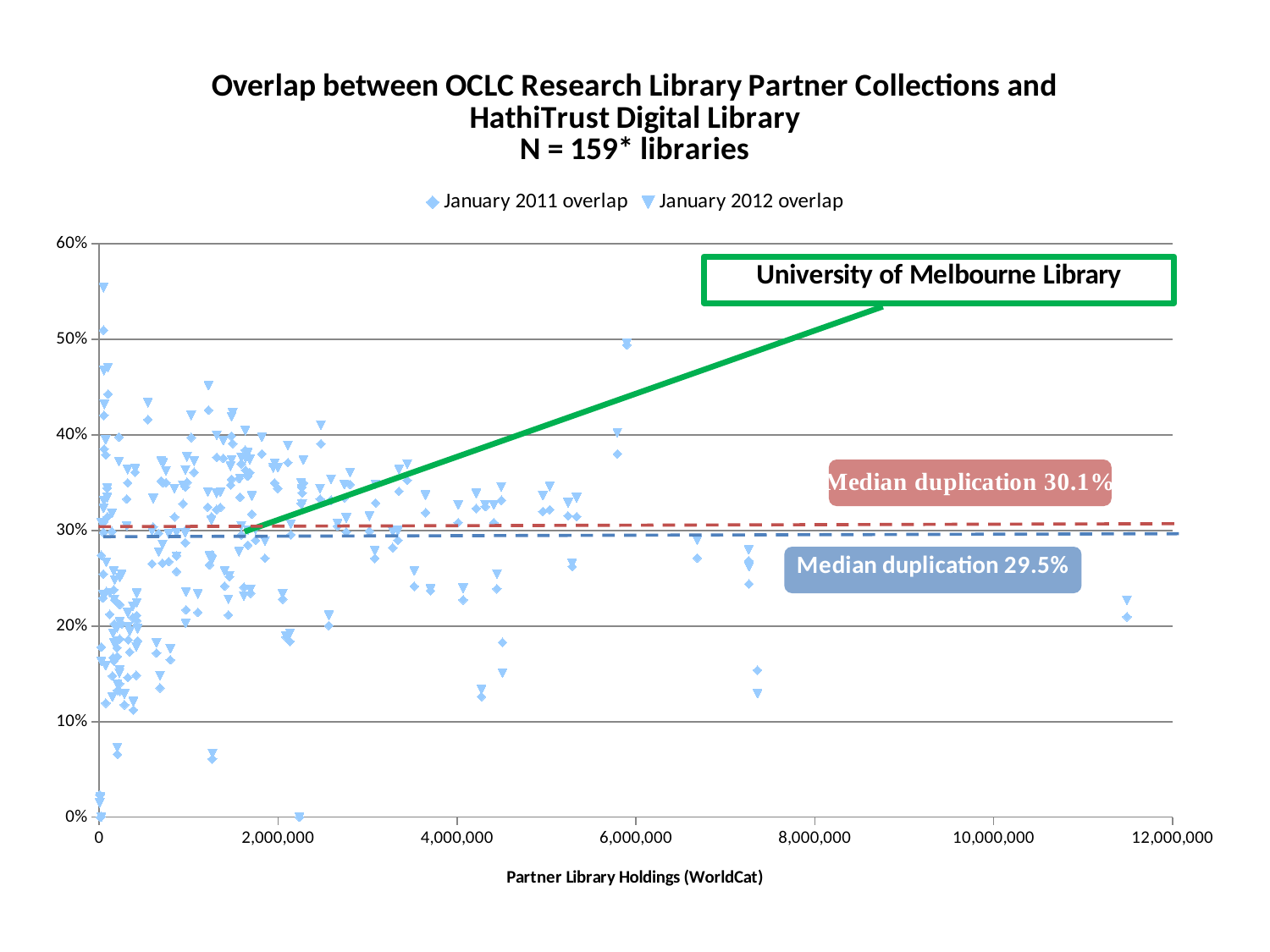
Which median duplication value is larger, the one in the red label or the one in the blue label? the red label (30.1%) What is the difference between the two median duplication values shown in the labels? 0.6% What median duplication value is shown in the red label? 30.1% What are the two series named in the legend? January 2011 overlap and January 2012 overlap What kind of chart is shown on the slide? scatter chart What is the title of the x axis? Partner Library Holdings (WorldCat) What median duplication value is shown in the blue label? 29.5% How many libraries does the chart title say are included (N)? 159 Which library is called out with the green annotation box? University of Melbourne Library How many series does the legend list? 2 Is the overlap value for the points plotted near 11,500,000 holdings greater or less than 30%? less Is the overlap value for the point plotted near 6,000,000 holdings at the top of the cluster greater or less than 40%? greater